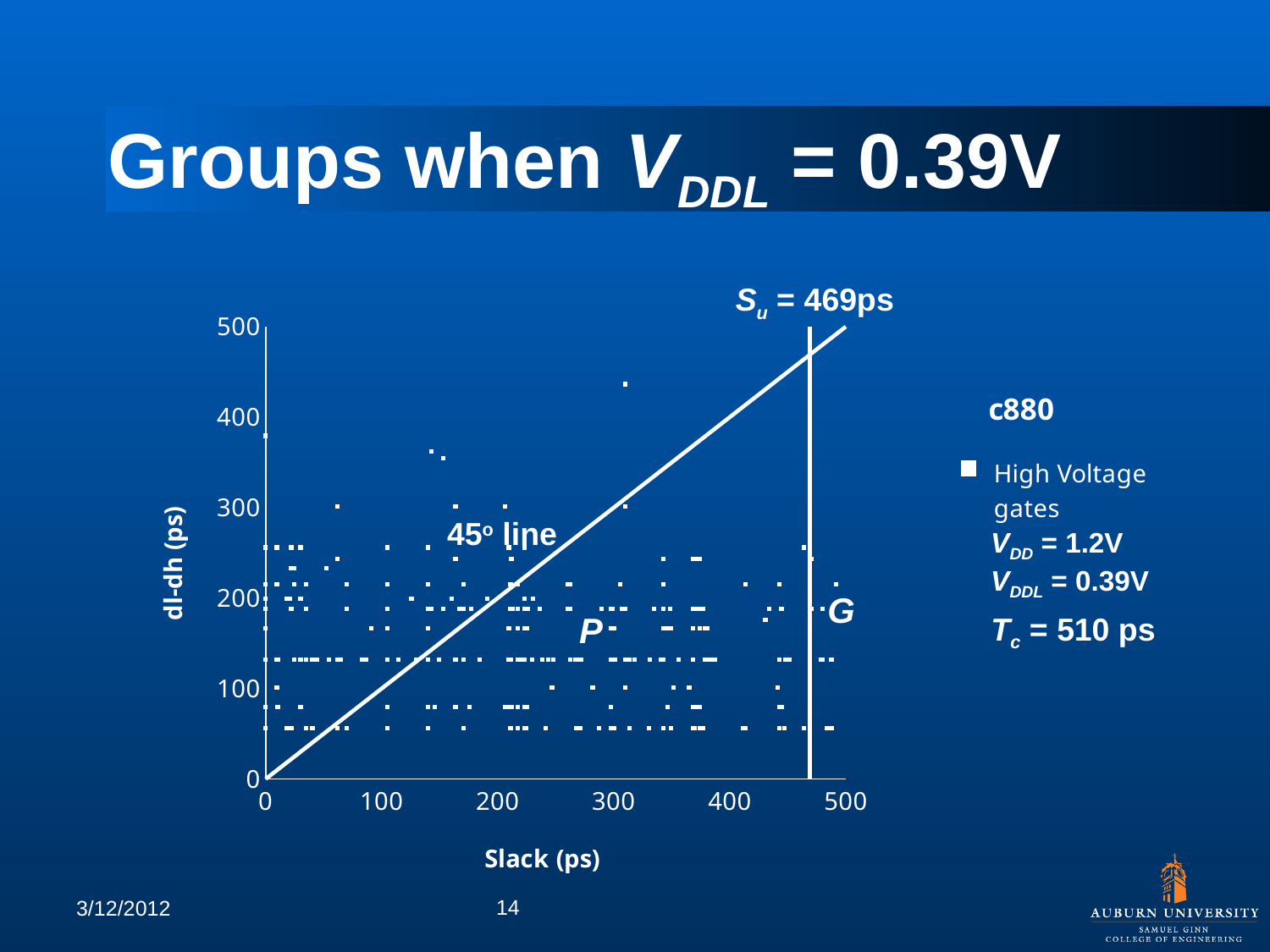
What is the value of VDD given next to the chart? 1.2V What is the value of Tc given next to the chart? 510 ps What is the maximum value shown on the x axis of the chart? 500 What value of Su is marked by the vertical line on the chart? 469ps Is the slack value of the vertical Su line greater or less than 400? greater What is the value of VDDL given next to the chart? 0.39V What is the label of the x axis of the chart? Slack (ps) What is the label of the y axis of the chart? dl-dh (ps) What is the maximum value shown on the y axis of the chart? 500 What is the diagonal line on the chart labelled as? 45° line Is the highest dl-dh value plotted on the chart greater or less than 400? greater What kind of chart is shown on the slide? scatter plot